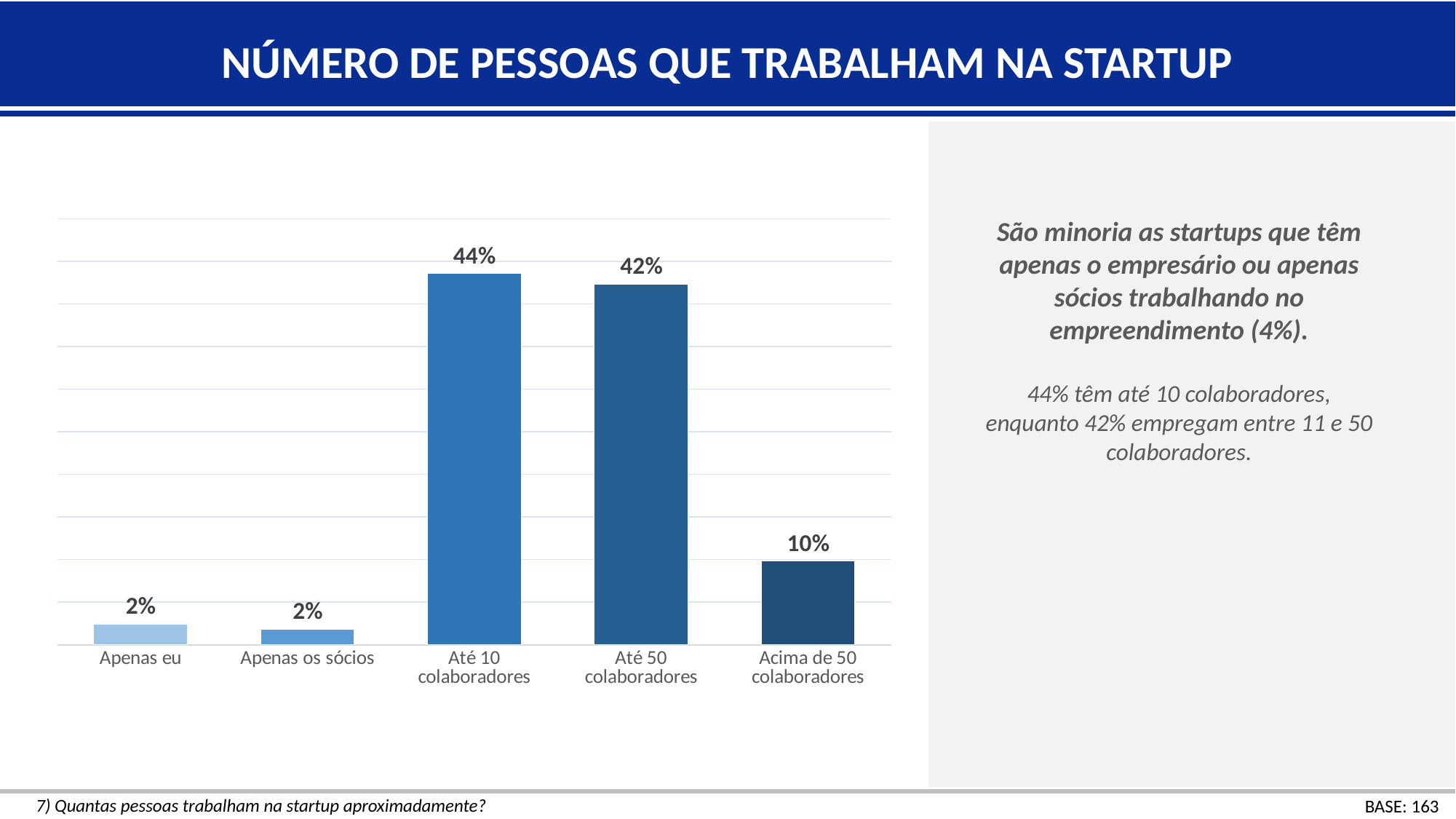
What is the value for "Até 10 colaboradores"? 44% Which category has the highest value? Até 10 colaboradores What kind of chart is shown on the slide? Bar chart What is the value for "Apenas eu"? 2% What is the title of the slide? NÚMERO DE PESSOAS QUE TRABALHAM NA STARTUP What is the combined value of "Apenas eu" and "Apenas os sócios"? 4% What is the value for "Acima de 50 colaboradores"? 10% What is the value for "Até 50 colaboradores"? 42% Which is larger, the value for "Acima de 50 colaboradores" or the value for "Apenas os sócios"? Acima de 50 colaboradores How many categories are shown in the chart? 5 What is the difference between the values for "Até 50 colaboradores" and "Acima de 50 colaboradores"? 32% What is the difference between the values for "Até 10 colaboradores" and "Até 50 colaboradores"? 2%